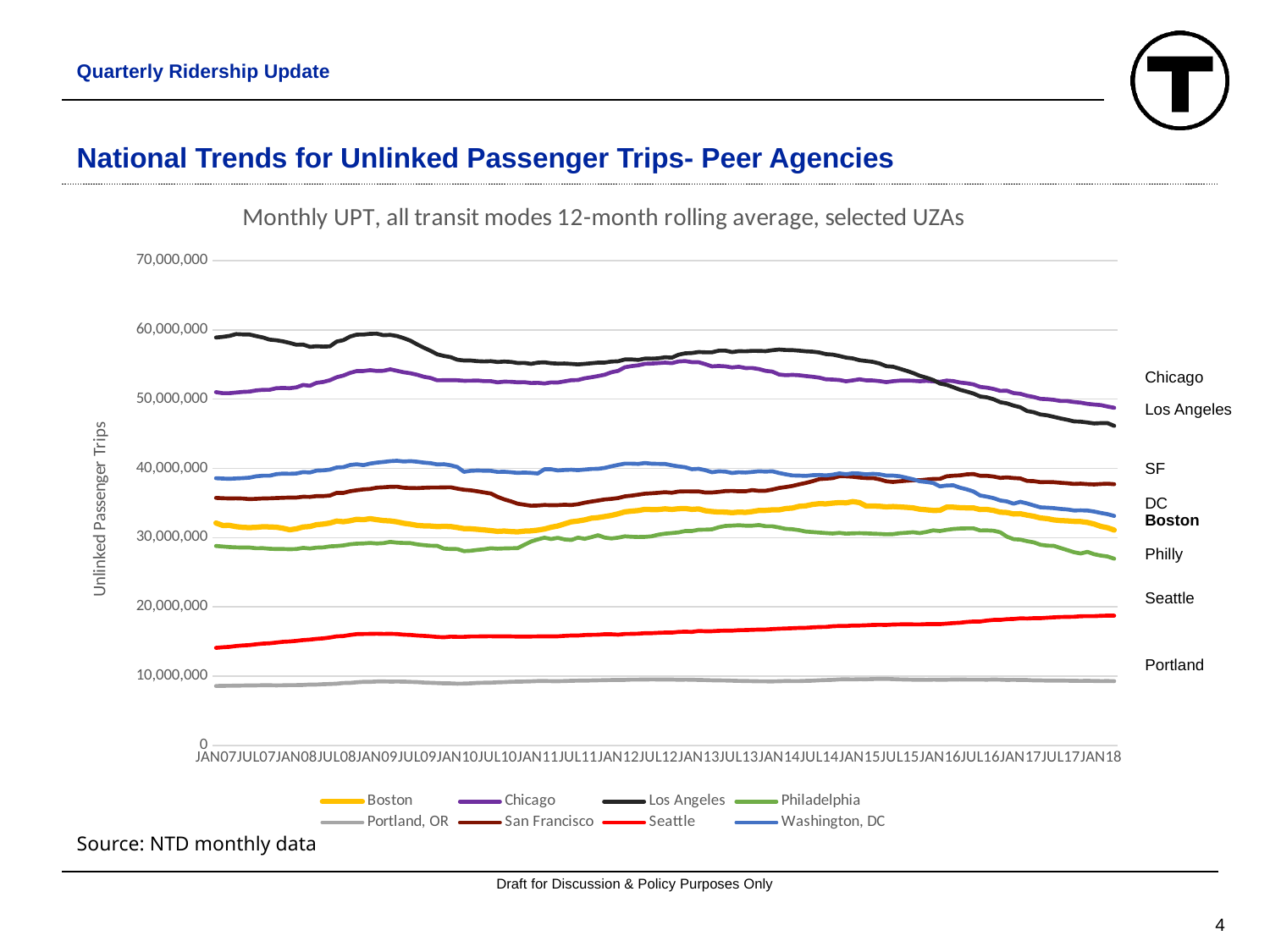
Is the value for Philadelphia at JAN18 greater or less than 30,000,000? less What is the title of the chart? Monthly UPT, all transit modes 12-month rolling average, selected UZAs At JAN18, which is larger: San Francisco or Boston? San Francisco Which series has the highest value at JAN07? Los Angeles What kind of chart is shown on the slide? Line chart What is the label on the vertical axis? Unlinked Passenger Trips Is the value for Seattle at JAN18 greater or less than 10,000,000? greater Is the value for Portland, OR at JAN18 greater or less than 10,000,000? less Does the Los Angeles line rise or fall from JAN07 to JAN18? Falls Does the Seattle line rise or fall from JAN07 to JAN18? Rises Which series has the lowest value across the whole chart? Portland, OR How many series does the legend list? 8